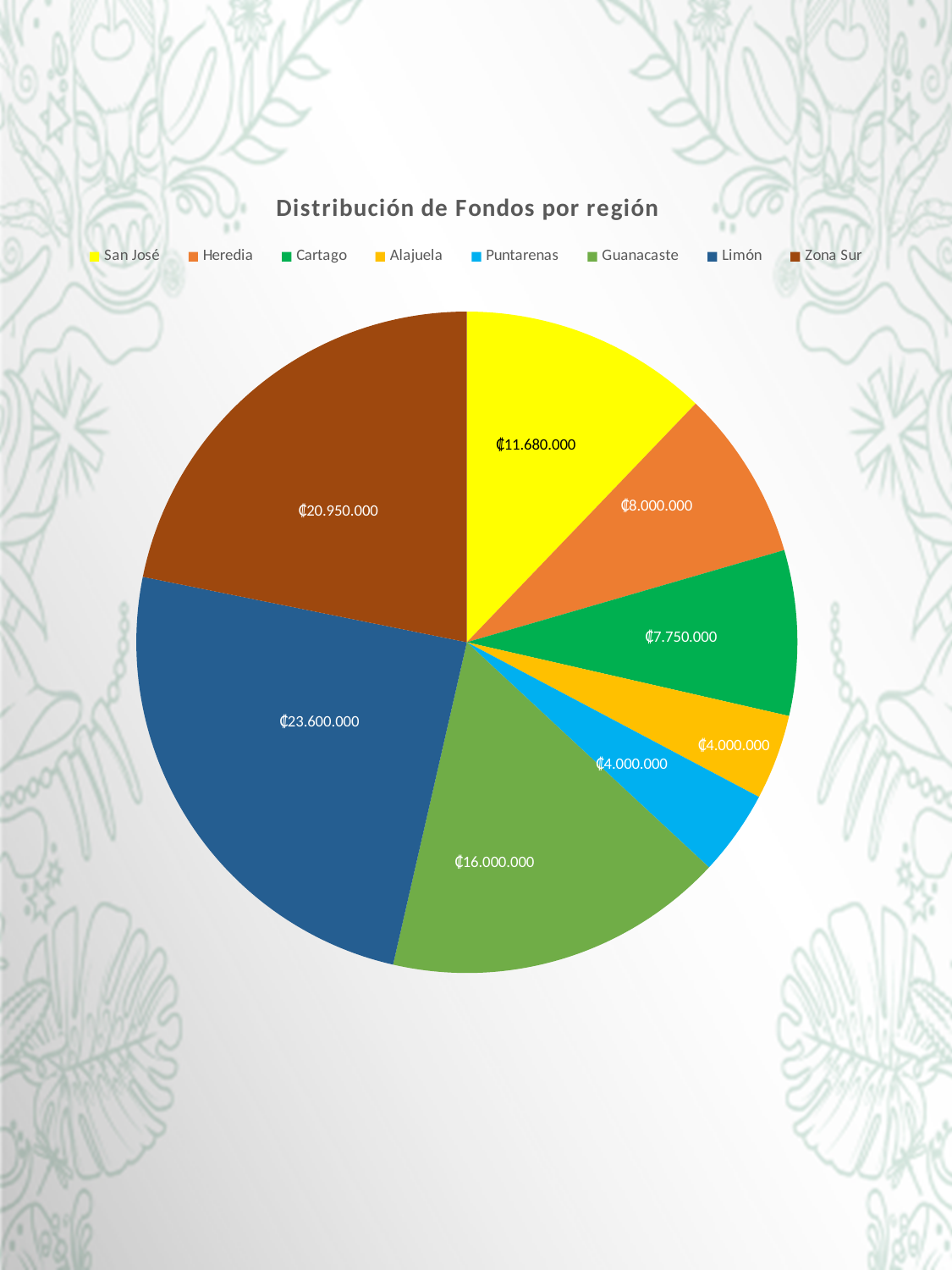
What is the value for Cartago? ₡7.750.000 Which is larger, the value for Heredia or the value for Cartago? Heredia What type of chart is shown on the slide? Pie chart What is the title of the chart? Distribución de Fondos por región What is the value for San José? ₡11.680.000 What is the value for Guanacaste? ₡16.000.000 How many regions are shown in the pie chart? 8 Which two regions have the smallest value, ₡4.000.000? Alajuela and Puntarenas Which colour represents Zona Sur in the legend? Brown What is the value for Limón? ₡23.600.000 Which region has the largest share of funds? Limón What is the difference between the values for Limón and Zona Sur? ₡2.650.000